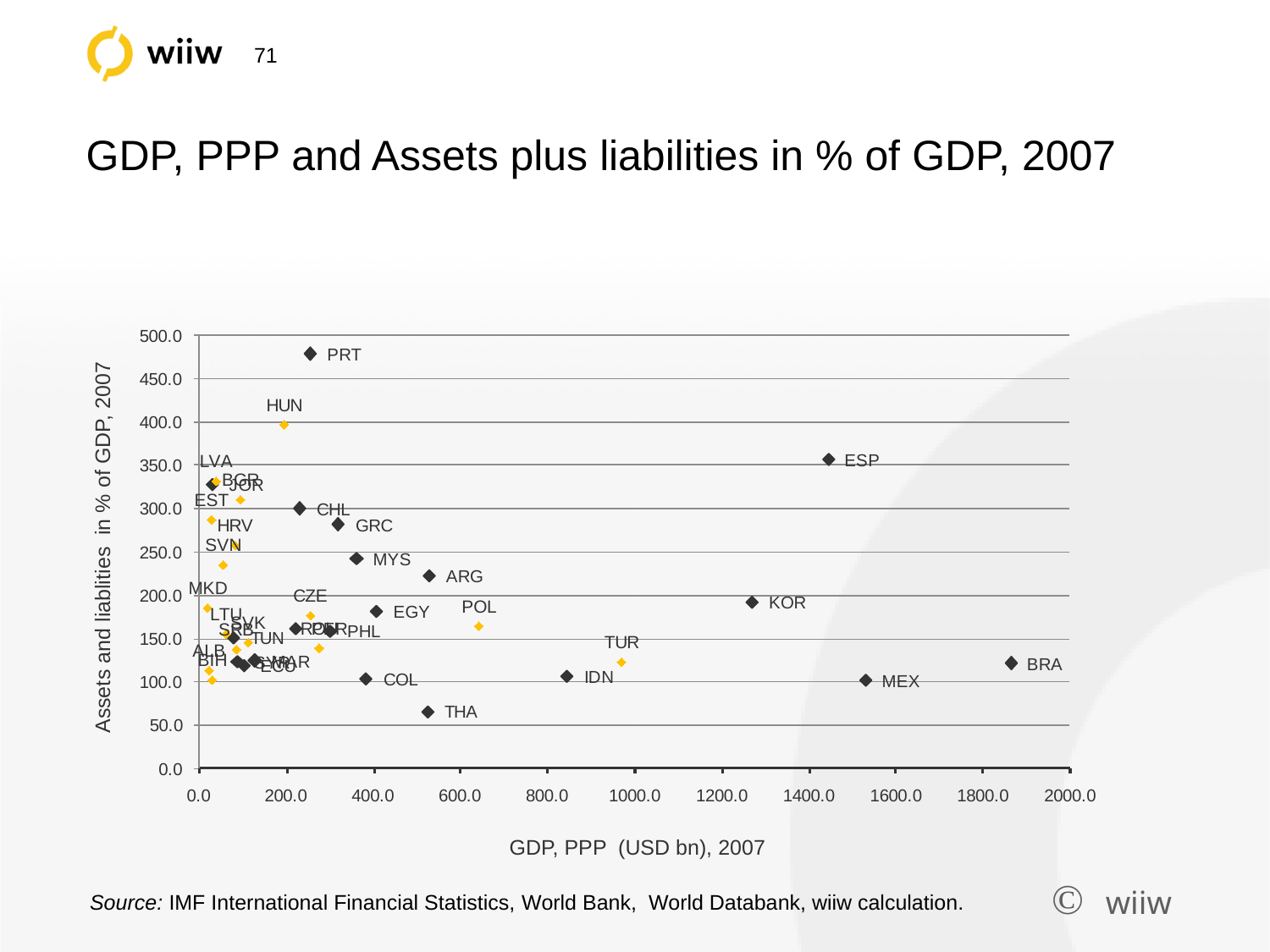
Which country has the lowest value of assets and liabilities in % of GDP? THA Which has a higher assets and liabilities value, ESP or KOR? ESP Which country has the highest GDP, PPP (USD bn) on the chart? BRA Is the assets and liabilities value for ESP greater or less than 300? greater What is the label of the x axis? GDP, PPP (USD bn), 2007 Is the assets and liabilities value for PRT greater or less than 450? greater Is the assets and liabilities value for MEX greater or less than 150? less Which has a higher GDP, PPP value, BRA or MEX? BRA What kind of chart is shown on the slide? Scatter chart Which country has the highest value of assets and liabilities in % of GDP? PRT